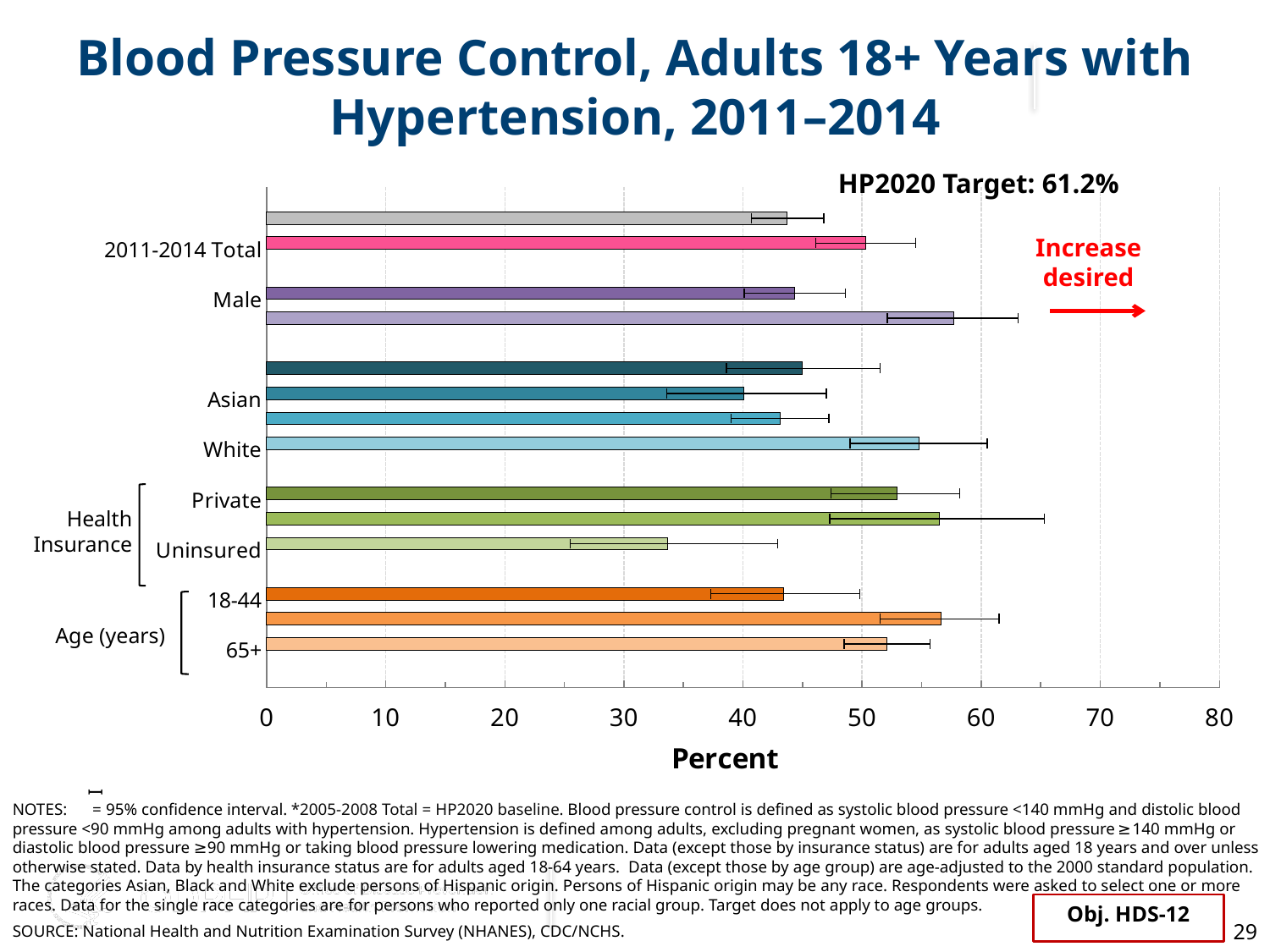
Among the labeled categories, which has the lowest value? Uninsured Is the value for Asian greater or less than 30? greater Which has the larger value, Private or Uninsured? Private Is the value for White greater or less than 50? greater What kind of chart is shown on the slide? bar chart Is the value for Male greater or less than 50? less What is the HP2020 Target value shown on the slide? 61.2% What is the title of the horizontal axis? Percent Which has the larger value, White or Asian? White